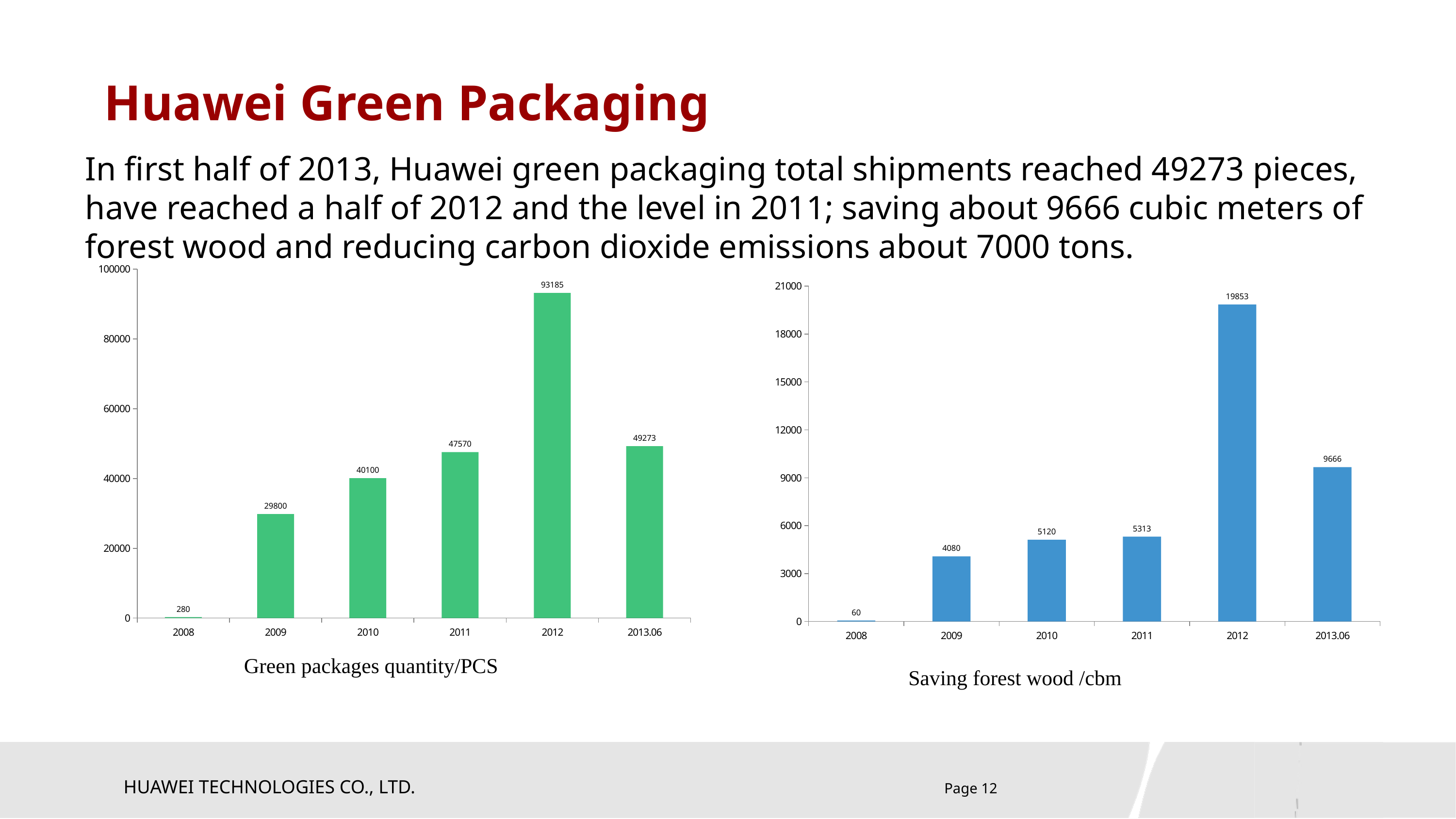
In the 'Green packages quantity/PCS' chart, which is larger, the value for 2011 or the value for 2010? 2011 In the 'Green packages quantity/PCS' chart, what is the value for 2009? 29800 In the 'Green packages quantity/PCS' chart, which year has the lowest value? 2008 What type of chart is the 'Saving forest wood /cbm' chart? bar chart In the 'Saving forest wood /cbm' chart, is the value for 2012 greater or less than 18000? greater In the 'Saving forest wood /cbm' chart, what is the value for 2013.06? 9666 How many categories are shown on the x axis of the 'Green packages quantity/PCS' chart? 6 In the 'Saving forest wood /cbm' chart, which year has the highest value? 2012 In the 'Green packages quantity/PCS' chart, what is the difference between the values for 2012 and 2013.06? 43912 In the 'Green packages quantity/PCS' chart, what is the value for 2012? 93185 In the 'Saving forest wood /cbm' chart, what is the value for 2011? 5313 In the 'Saving forest wood /cbm' chart, what is the difference between the values for 2010 and 2009? 1040